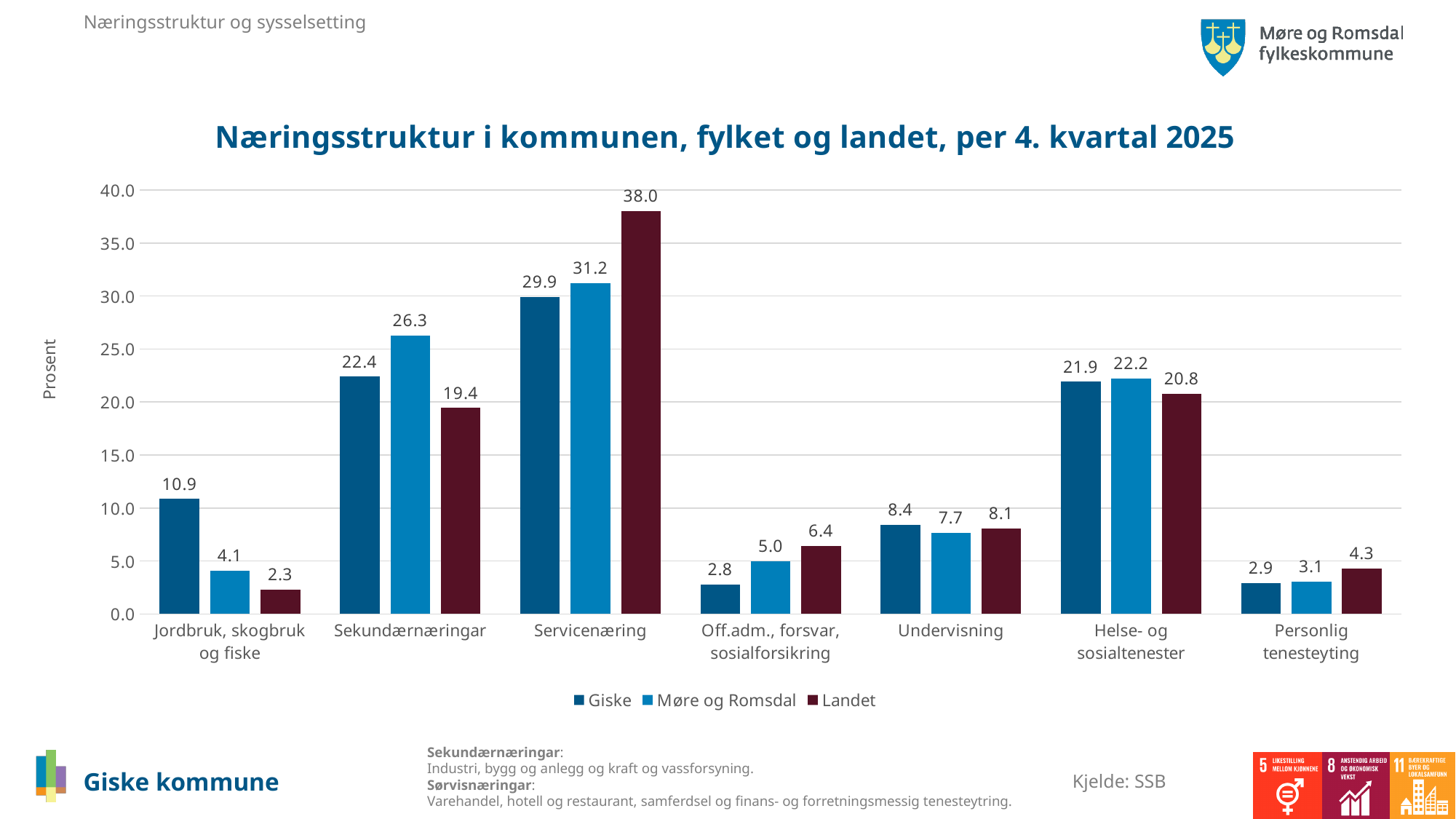
What is the value for Møre og Romsdal in the Sekundærnæringar category? 26.3 What is the title of the chart? Næringsstruktur i kommunen, fylket og landet, per 4. kvartal 2025 Which category has the lowest value for Landet? Jordbruk, skogbruk og fiske How many categories are shown on the x axis? 7 What is the difference between the Landet and Giske values in the Servicenæring category? 8.1 What is the value for Landet in the Servicenæring category? 38.0 What is the value for Giske in the Jordbruk, skogbruk og fiske category? 10.9 How many series does the legend list? 3 What kind of chart is shown on the slide? Bar chart Is the value for Giske in the Helse- og sosialtenester category greater or less than 20.0? greater Which category has the highest value for Giske? Servicenæring In the Sekundærnæringar category, which is larger: the value for Møre og Romsdal or the value for Landet? Møre og Romsdal